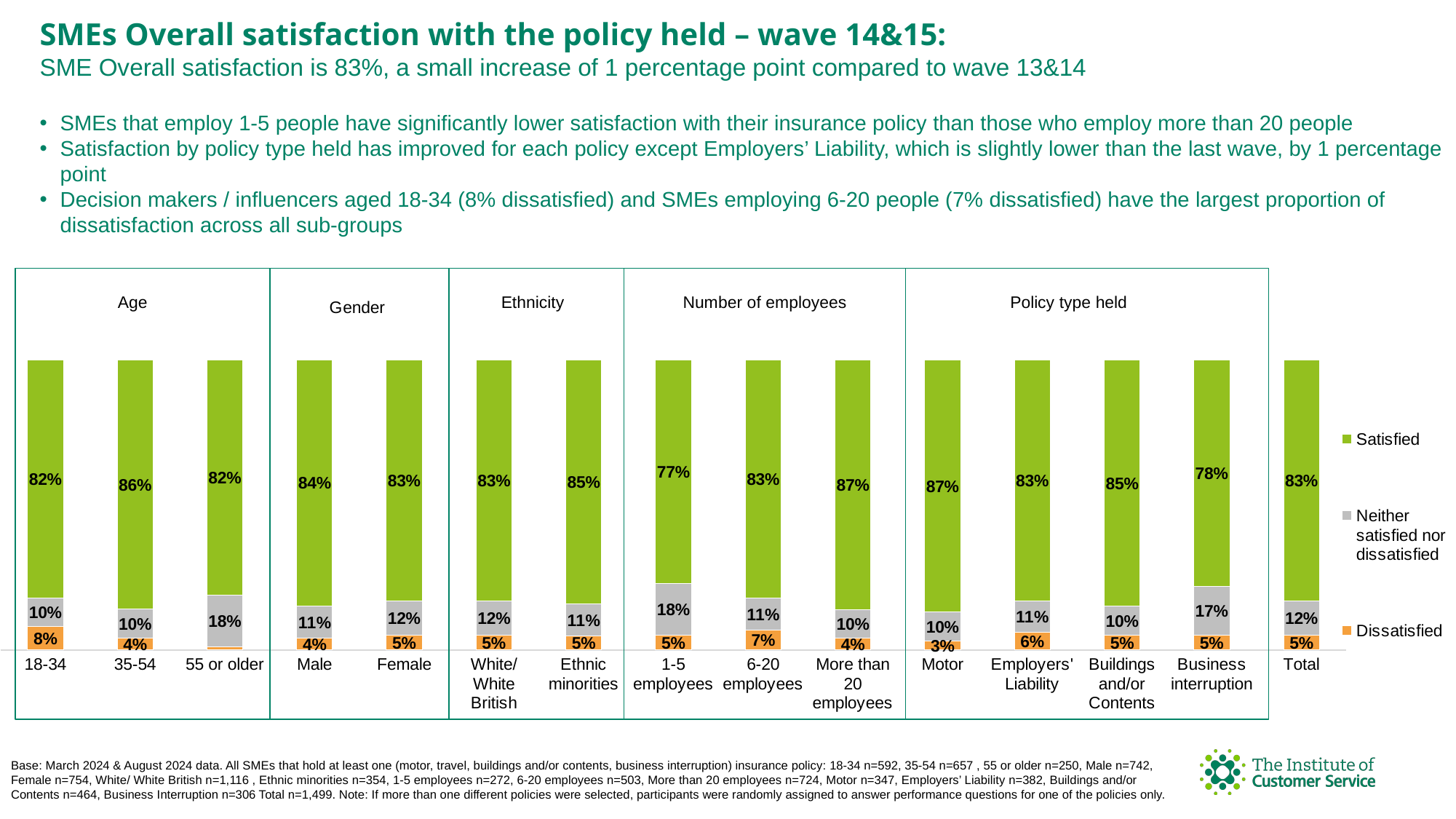
What is the Satisfied value for the Total bar? 83% What is the Neither satisfied nor dissatisfied value for Business interruption? 17% What is the Satisfied value for SMEs with 1-5 employees? 77% Which category has the lowest Dissatisfied value among those with a printed label? Motor Which colour represents the Satisfied series in the chart? Green What kind of chart is shown on the slide? Stacked bar chart What is the difference between the Satisfied values for More than 20 employees and 1-5 employees? 10 percentage points How many categories (bars) are plotted on the chart? 15 Which category has the lowest Satisfied value? 1-5 employees What is the Dissatisfied value for the 18-34 age group? 8% Which has a higher Satisfied value, Motor or Business interruption? Motor How many series does the legend list? 3